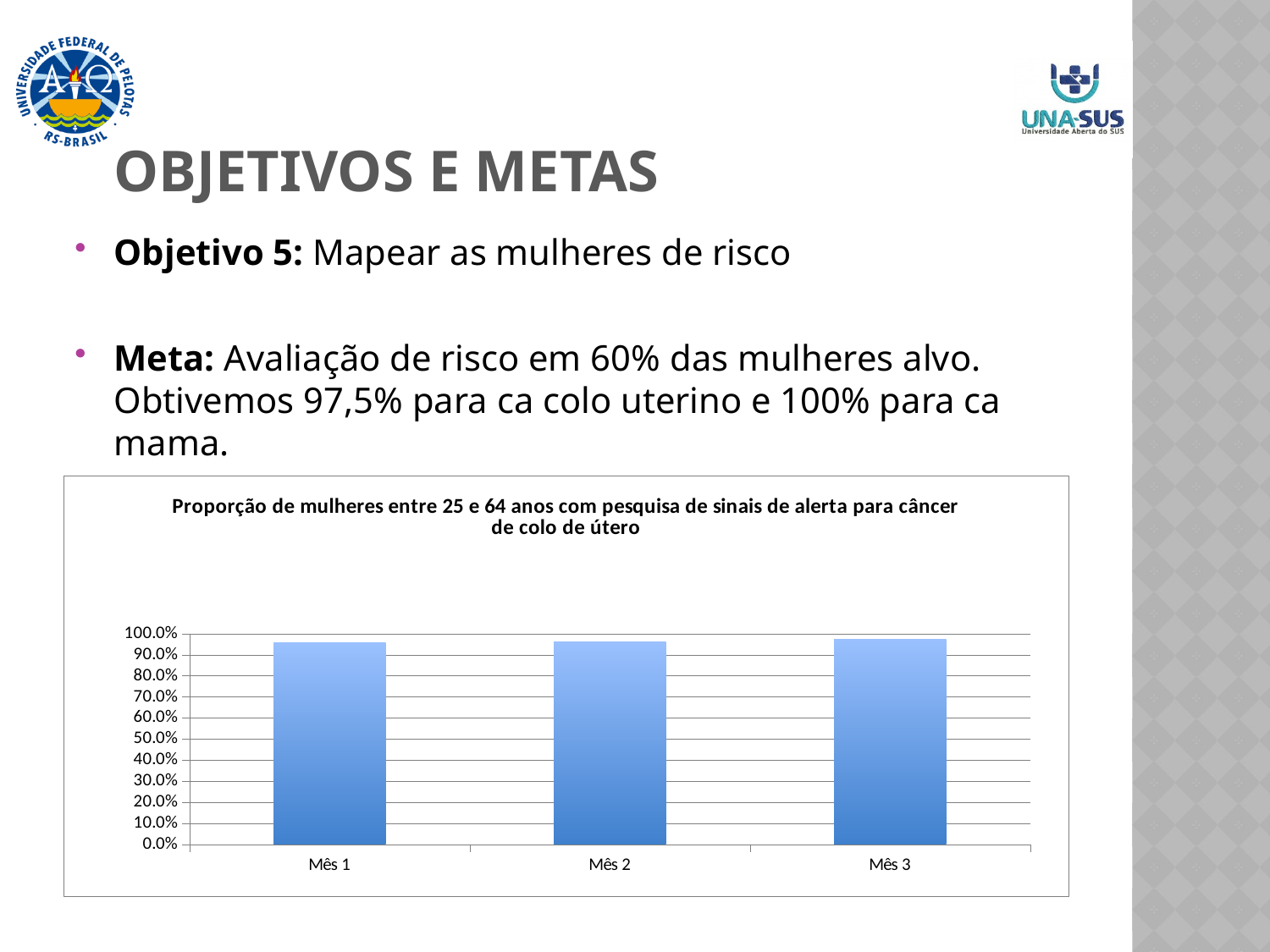
How many categories are shown on the x axis of the chart? 3 What is the title of the chart? Proporção de mulheres entre 25 e 64 anos com pesquisa de sinais de alerta para câncer de colo de útero Is the value for Mês 2 greater or less than 60.0%? greater Is the value for Mês 2 greater or less than 90.0%? greater What is the label of the first category on the x axis of the chart? Mês 1 What kind of chart is shown on the slide? bar chart Is the value for Mês 1 greater or less than 100.0%? less